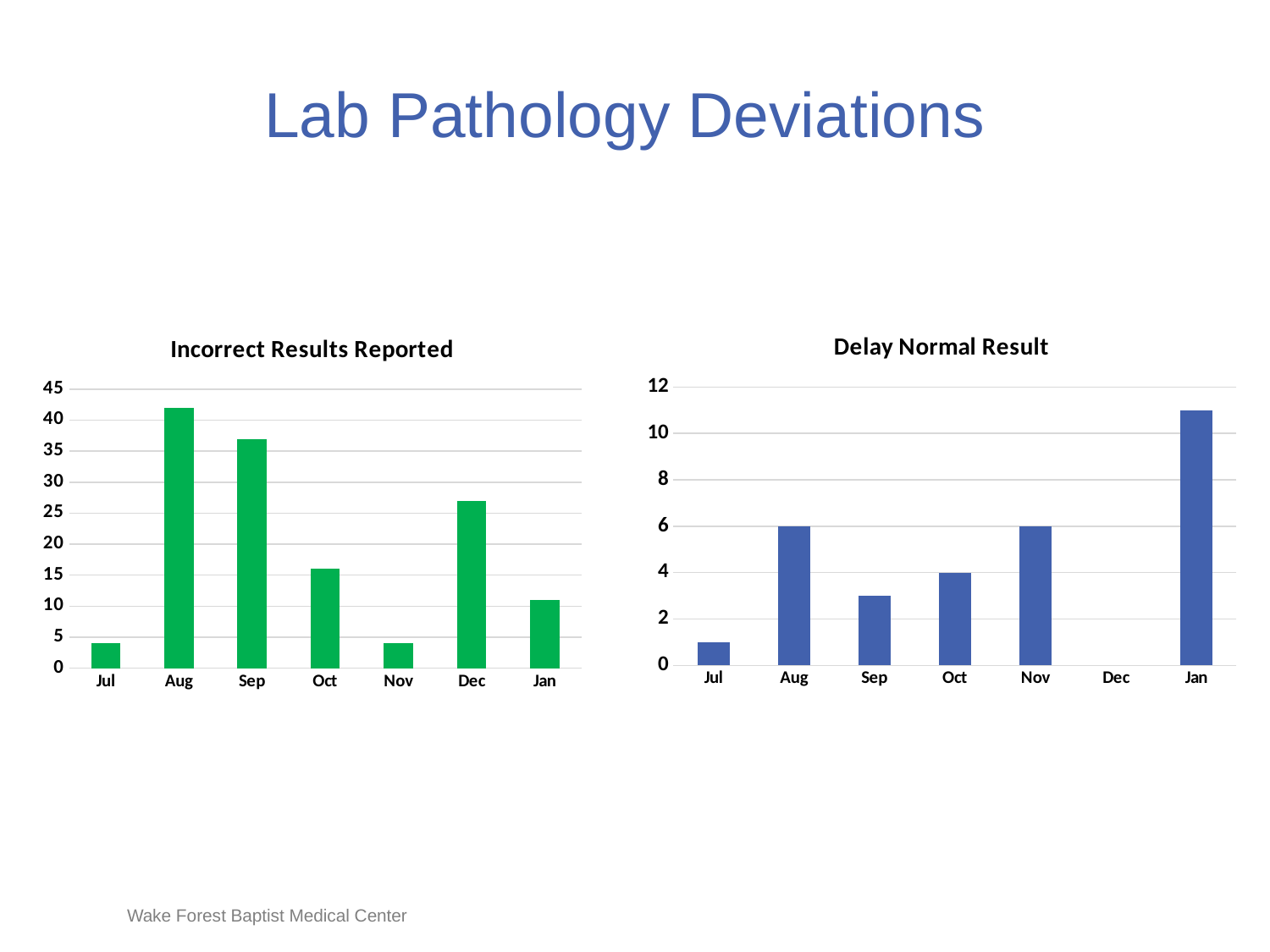
In the Delay Normal Result chart, is the value for Jan greater or less than 10? greater How many months are shown on the x axis of the Incorrect Results Reported chart? 7 In the Incorrect Results Reported chart, is the value for Oct greater or less than 20? less In the Delay Normal Result chart, what is the value for Nov? 6 In the Incorrect Results Reported chart, which month has the highest value? Aug What kind of chart is the Delay Normal Result chart? Bar chart In the Incorrect Results Reported chart, which is larger, the value for Sep or the value for Dec? Sep In the Delay Normal Result chart, what is the value for Aug? 6 In the Delay Normal Result chart, which month has the highest value? Jan In the Incorrect Results Reported chart, is the value for Aug greater or less than 40? greater In the Delay Normal Result chart, what is the value for Oct? 4